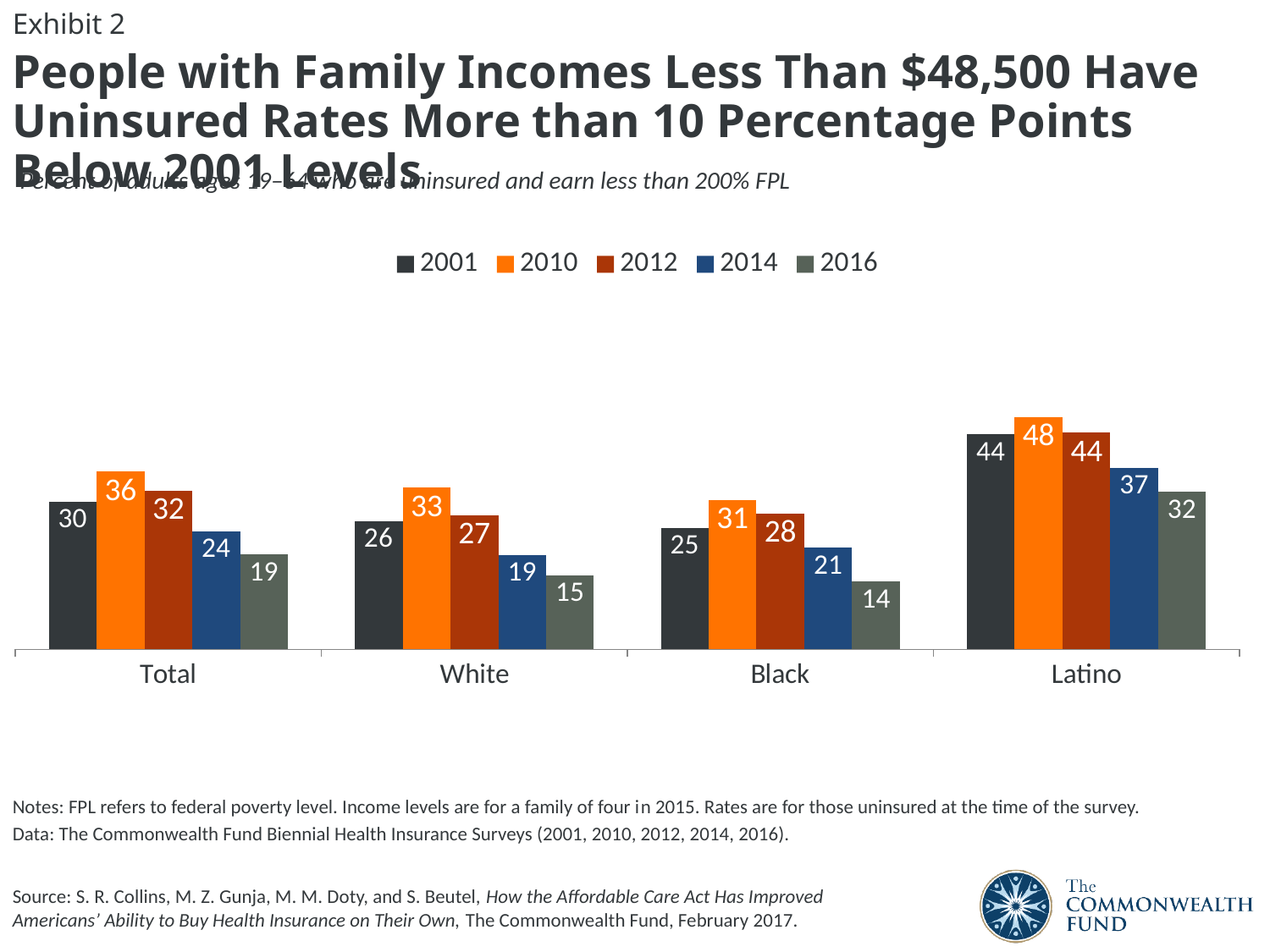
Which is larger, the 2012 value for White or the 2012 value for Black? Black What is the value for Black in 2016? 14 What is the value for Latino in 2010? 48 Which category has the highest value in 2016? Latino How many series does the legend list? 5 What is the value for White in 2001? 26 What is the difference between the 2001 and 2016 values for Total? 11 How many categories are shown on the x axis? 4 For Latino, do the values rise or fall from 2010 to 2016? Fall What kind of chart is shown on the slide? Bar chart Which category has the lowest value in 2014? White Which year is shown in orange in the legend? 2010